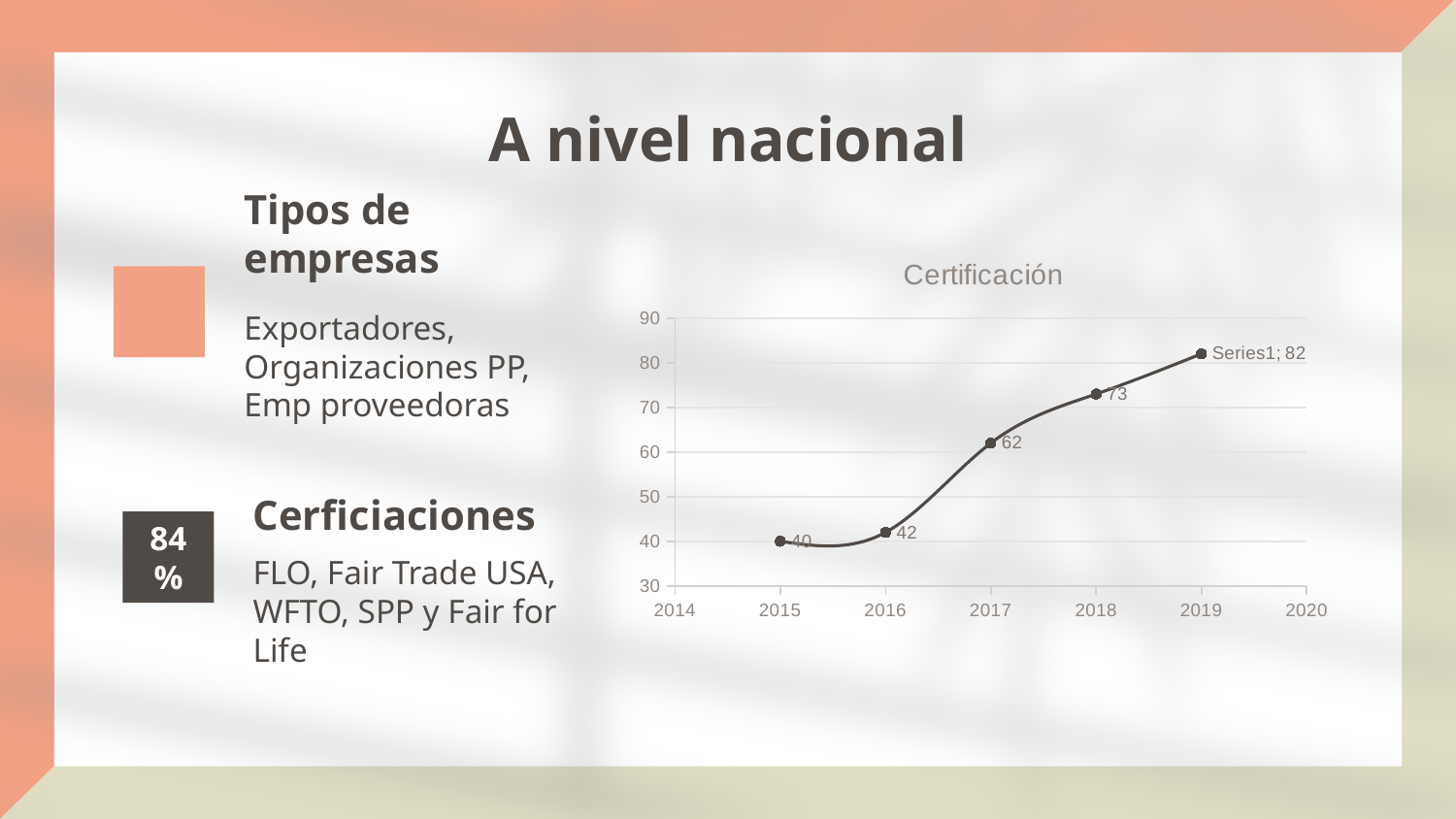
What type of chart is shown on the slide? line chart What is the title of the chart? Certificación What is the difference between the values for 2019 and 2015? 42 What is the value plotted for 2019? 82 Which year has the highest value? 2019 Which is larger, the value for 2016 or the value for 2017? 2017 What is the value plotted for 2015? 40 How many data points are plotted on the line? 5 Which year has the lowest value? 2015 Do the values rise or fall from 2015 to 2019? rise What is the value plotted for 2018? 73 What is the value plotted for 2017? 62